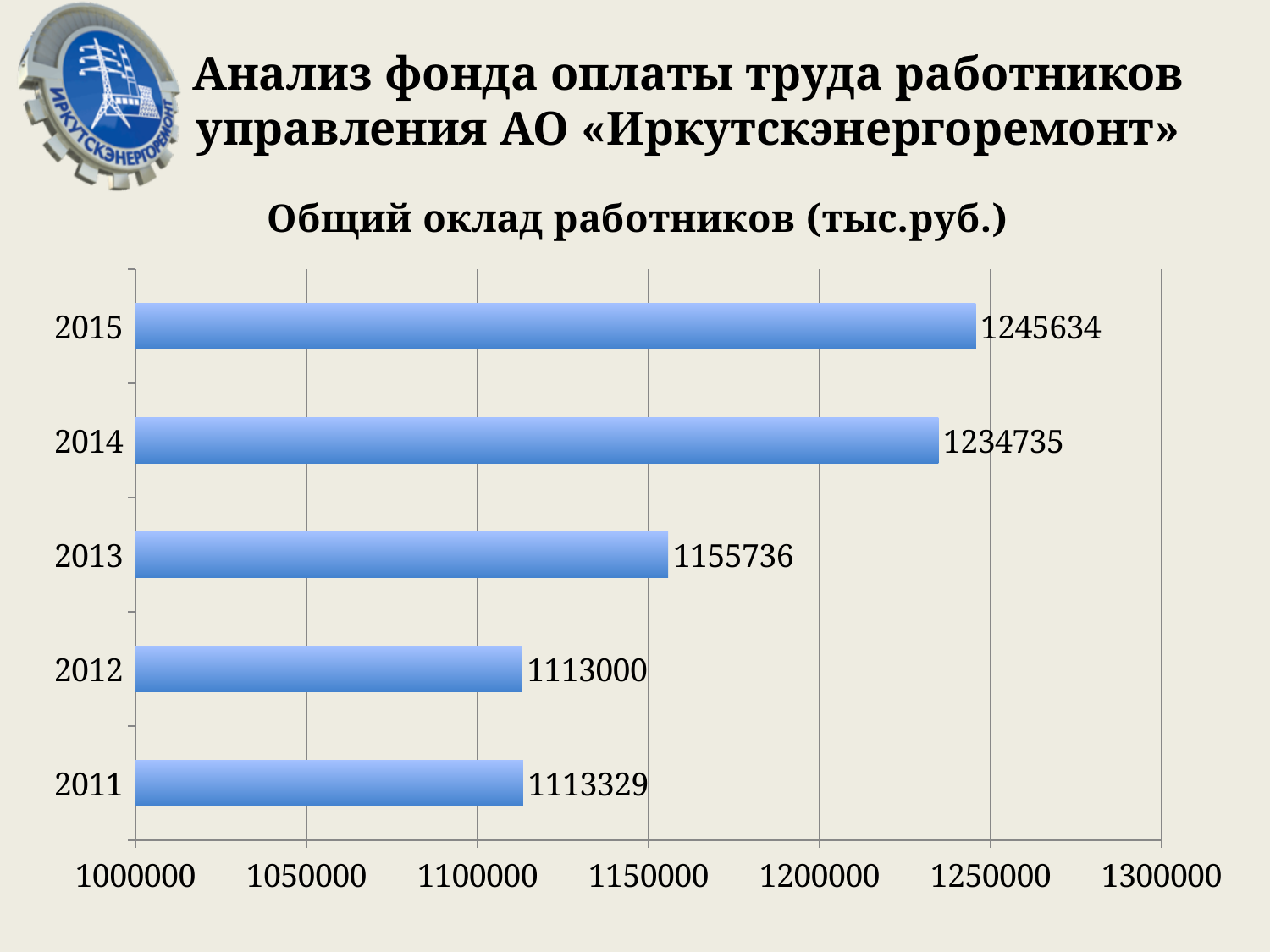
Which year has the highest value? 2015 Do the values generally rise or fall from 2011 to 2015? rise How many years are shown in the chart? 5 What is the value for 2015? 1245634 What is the difference between the values for 2013 and 2012? 42736 What is the value for 2013? 1155736 What kind of chart is shown on the slide? bar chart Is the value for 2012 greater or less than 1150000? less Which is larger, the value for 2014 or the value for 2013? 2014 What is the difference between the values for 2015 and 2014? 10899 What is the title of the chart? Общий оклад работников (тыс.руб.) What is the value for 2011? 1113329